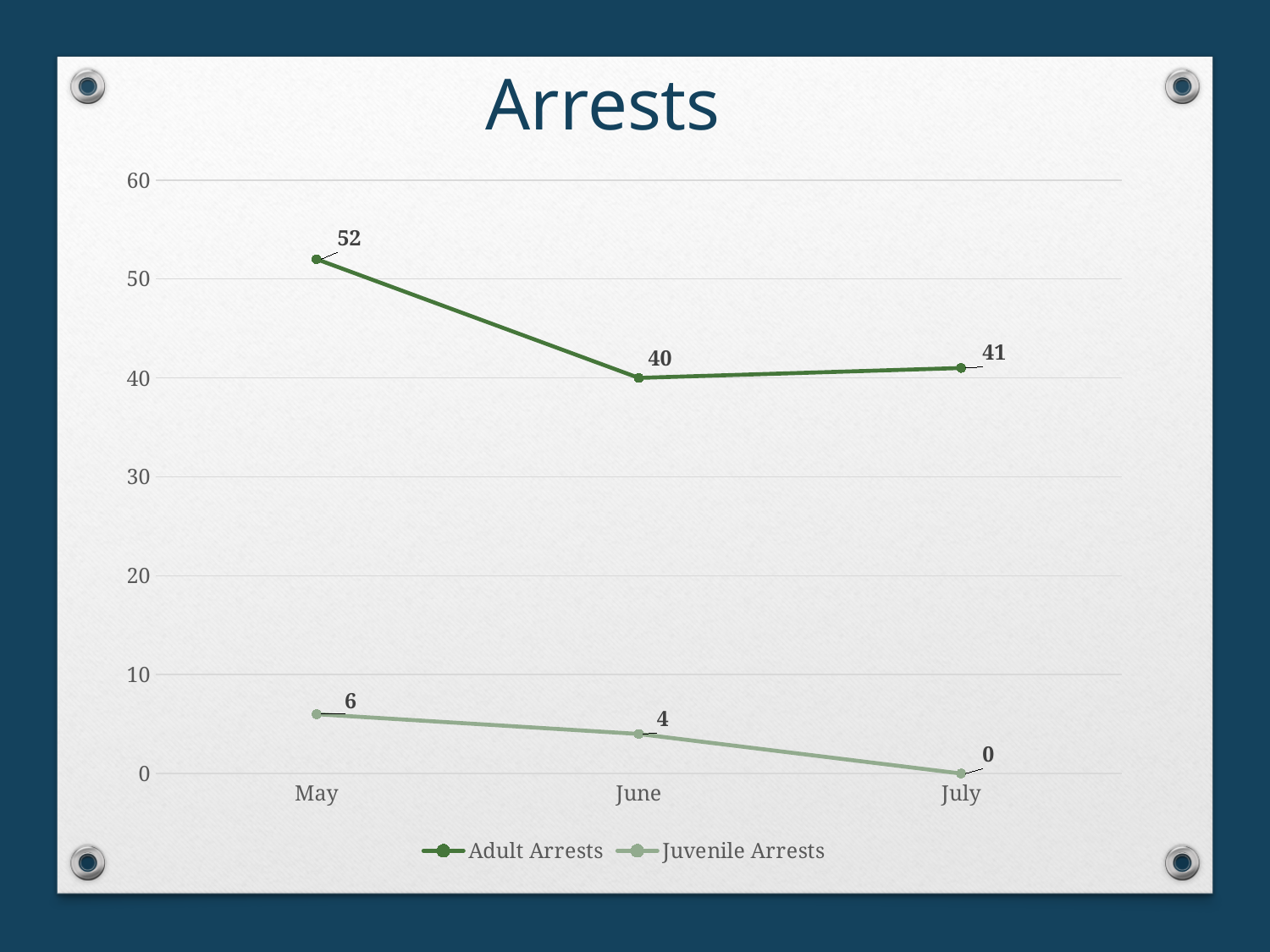
What is the title of the chart? Arrests Do Juvenile Arrests rise or fall from May to July? Fall What is the value for Adult Arrests in May? 52 How many series does the legend list? 2 In which month are Adult Arrests highest? May What kind of chart is shown on the slide? Line chart How many months are shown on the x axis? 3 Which is larger, Adult Arrests in June or Adult Arrests in July? Adult Arrests in July In which month are Juvenile Arrests lowest? July What is the value for Juvenile Arrests in July? 0 What is the difference between Adult Arrests in May and June? 12 What is the value for Juvenile Arrests in June? 4